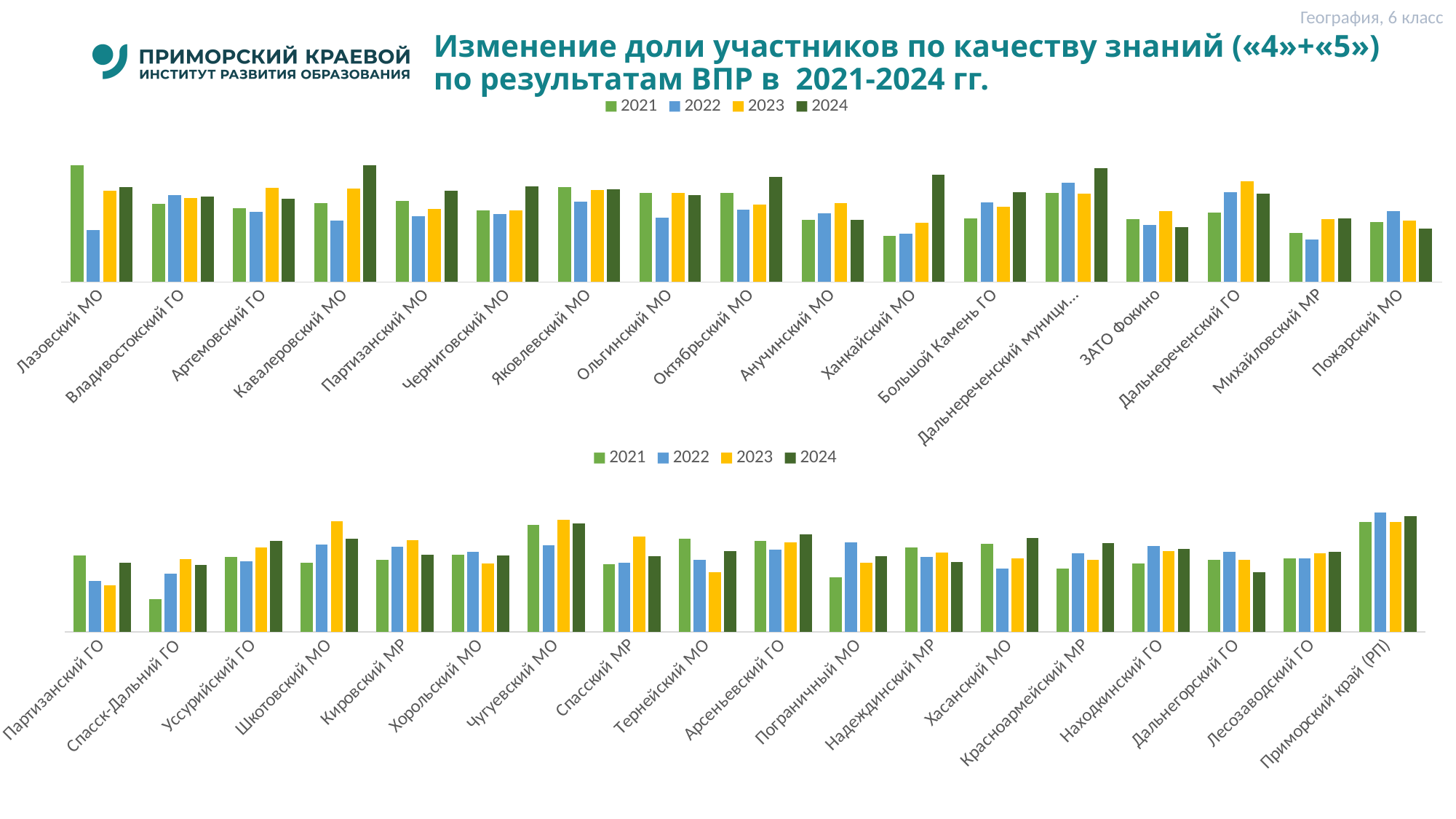
In the top chart, which year has the lowest bar for Лазовский МО? 2022 In the top chart, which year has the highest bar for Кавалеровский МО? 2024 In the bottom chart, is the 2021 bar or the 2022 bar larger for Пограничный МО? 2022 In the bottom chart, which year has the lowest bar for Спасск-Дальний ГО? 2021 In the top chart, is the 2021 bar or the 2022 bar larger for Лазовский МО? 2021 Which years are listed in the legend of the bottom chart? 2021, 2022, 2023, 2024 In the bottom chart, which year has the highest bar for Шкотовский МО? 2023 How many series does the legend of the top chart list? 4 How many categories are shown on the x axis of the top chart? 17 In the top chart, do the bars for Ханкайский МО rise or fall from 2021 to 2024? rise What kind of chart is the top chart on the slide? bar chart How many categories are shown on the x axis of the bottom chart? 18